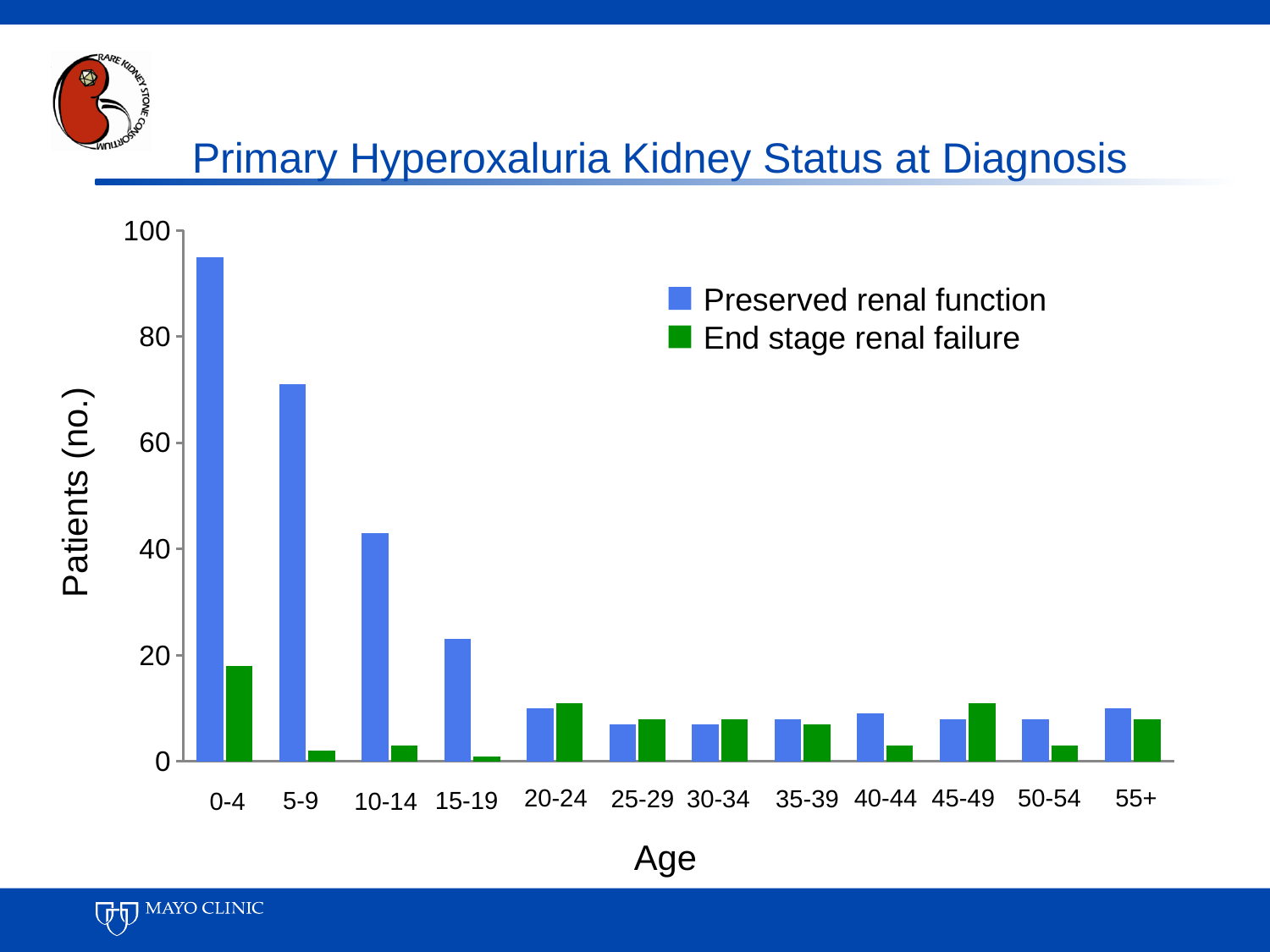
Is the number of patients with preserved renal function in the 0-4 age group greater or less than 80? greater Is the number of patients with end stage renal failure in the 0-4 age group greater or less than 20? less How many series does the legend list? 2 Which age group has the highest number of patients with preserved renal function? 0-4 How many age groups are shown on the x axis? 12 What kind of chart is shown on the slide? Bar chart Which age group has the lowest number of patients with end stage renal failure? 15-19 In the 40-44 age group, which is larger: preserved renal function or end stage renal failure? Preserved renal function What is the label of the y axis? Patients (no.) Do the preserved renal function values rise or fall from the 0-4 age group to the 15-19 age group? Fall Is the number of patients with preserved renal function in the 5-9 age group greater or less than 60? greater Which age group has the highest number of patients with end stage renal failure? 0-4